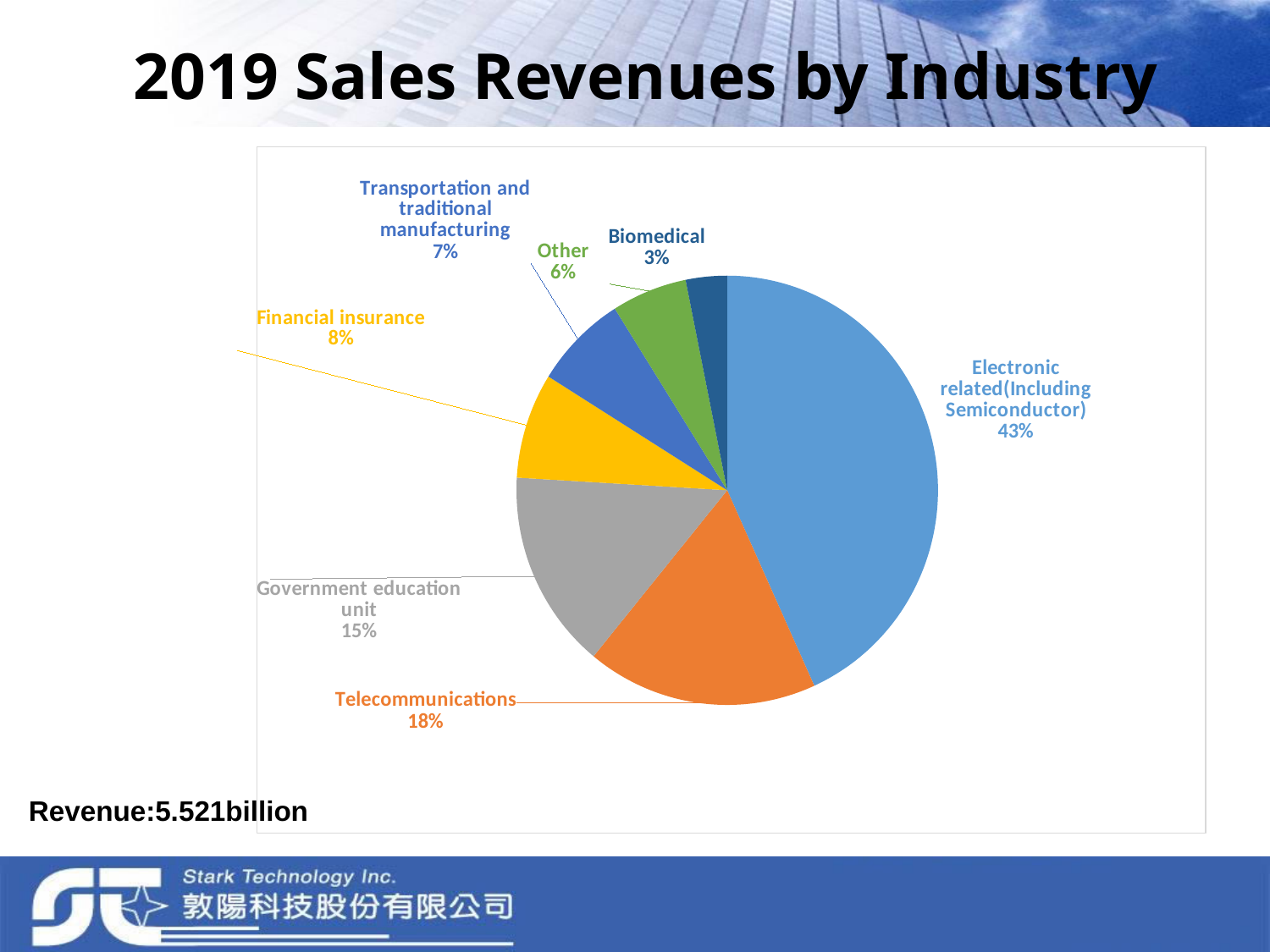
What is the difference in percentage points between the Telecommunications share and the Government education unit share? 3% What share of 2019 sales revenues comes from Government education unit? 15% Which industry has the smallest share of 2019 sales revenues? Biomedical What is the title of the chart on the slide? 2019 Sales Revenues by Industry What share of 2019 sales revenues comes from Financial insurance? 8% What share of 2019 sales revenues comes from Telecommunications? 18% How many industry categories are shown in the pie chart? 7 What kind of chart is shown on the slide? pie chart Which has a larger share, Transportation and traditional manufacturing or Other? Transportation and traditional manufacturing Which industry has the largest share of 2019 sales revenues? Electronic related(Including Semiconductor)